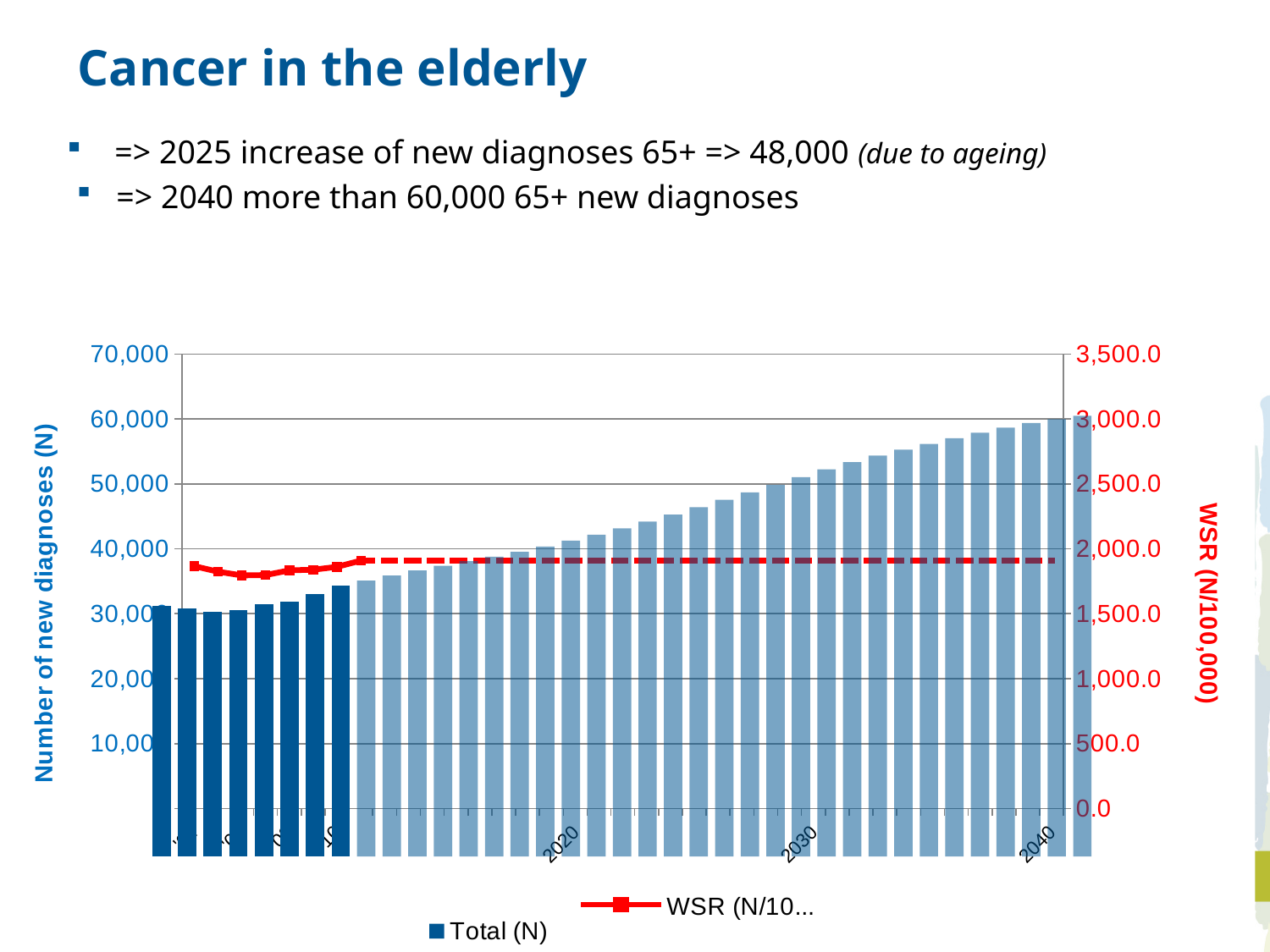
What kind of chart is shown on the slide? A bar chart combined with a line chart How many series does the legend list? 2 What is the title of the left vertical axis? Number of new diagnoses (N) Is the Total (N) value for 2030 greater or less than 60,000? less Is the WSR value for 2030 greater or less than 2,500.0? less Is the Total (N) value for 2030 greater or less than 40,000? greater What is the title of the right vertical axis? WSR (N/100,000) Which series is plotted as bars? Total (N) Which year has a larger Total (N) value, 2020 or 2040? 2040 Do the Total (N) bars rise or fall from left to right along the x axis? Rise